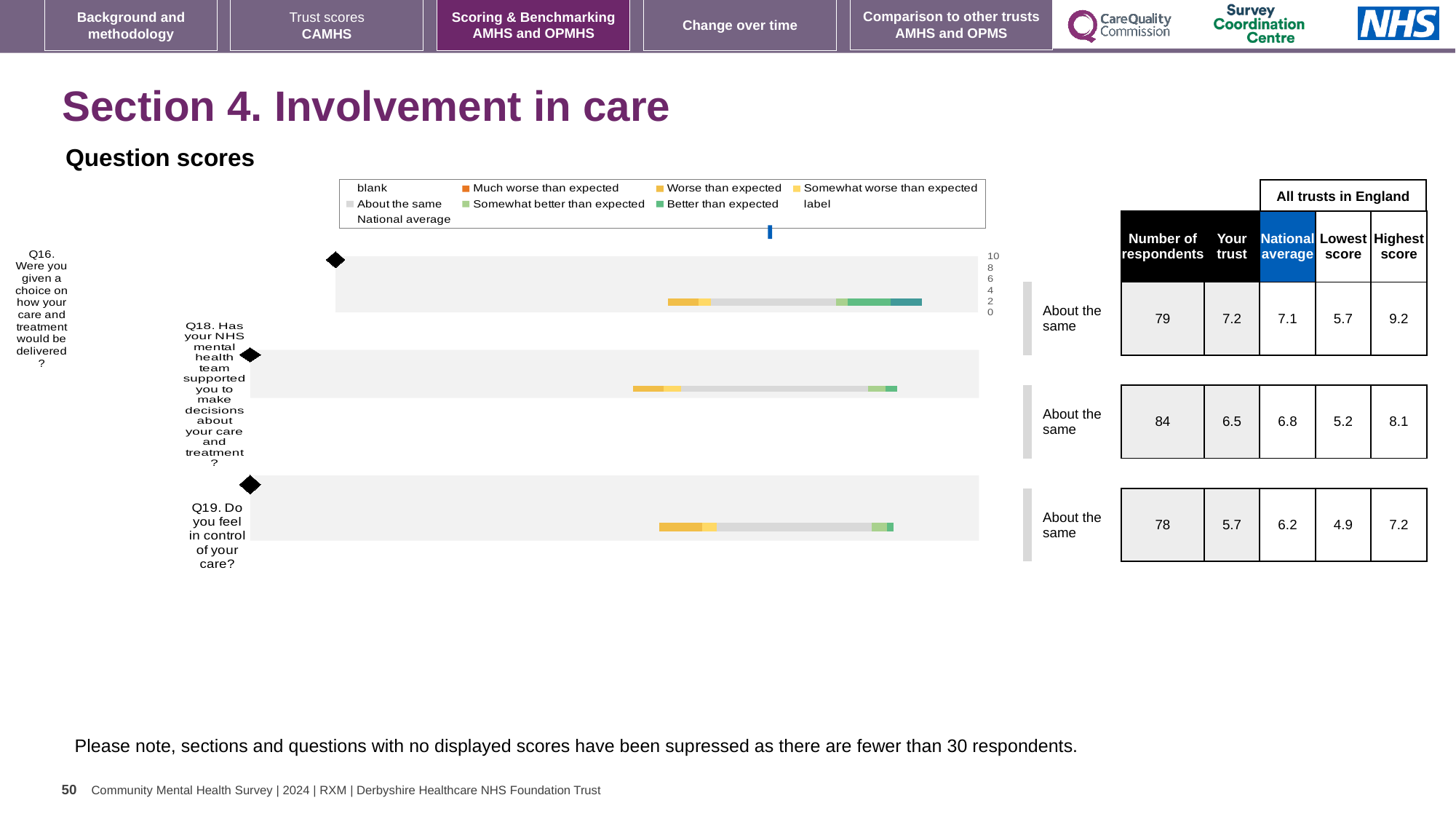
What kind of chart is used to show the question scores? bar chart For Q19, how much higher is the national average than the 'Your trust' score? 0.5 What is the 'Your trust' score for Q16 (Were you given a choice on how your care and treatment would be delivered?)? 7.2 For Q16, what is the difference between the highest score and the lowest score across all trusts in England? 3.5 What is the lowest score across all trusts in England for Q19? 4.9 For Q18, which is larger: the 'Your trust' score or the national average? National average Which question has the highest 'Your trust' score? Q16 How many respondents answered Q19 (Do you feel in control of your care?)? 78 Which question has the lowest 'Your trust' score? Q19 What is the national average score for Q18 (Has your NHS mental health team supported you to make decisions about your care and treatment?)? 6.8 How many survey questions are plotted in the Question scores chart? 3 What benchmark category is shown for Q18? About the same